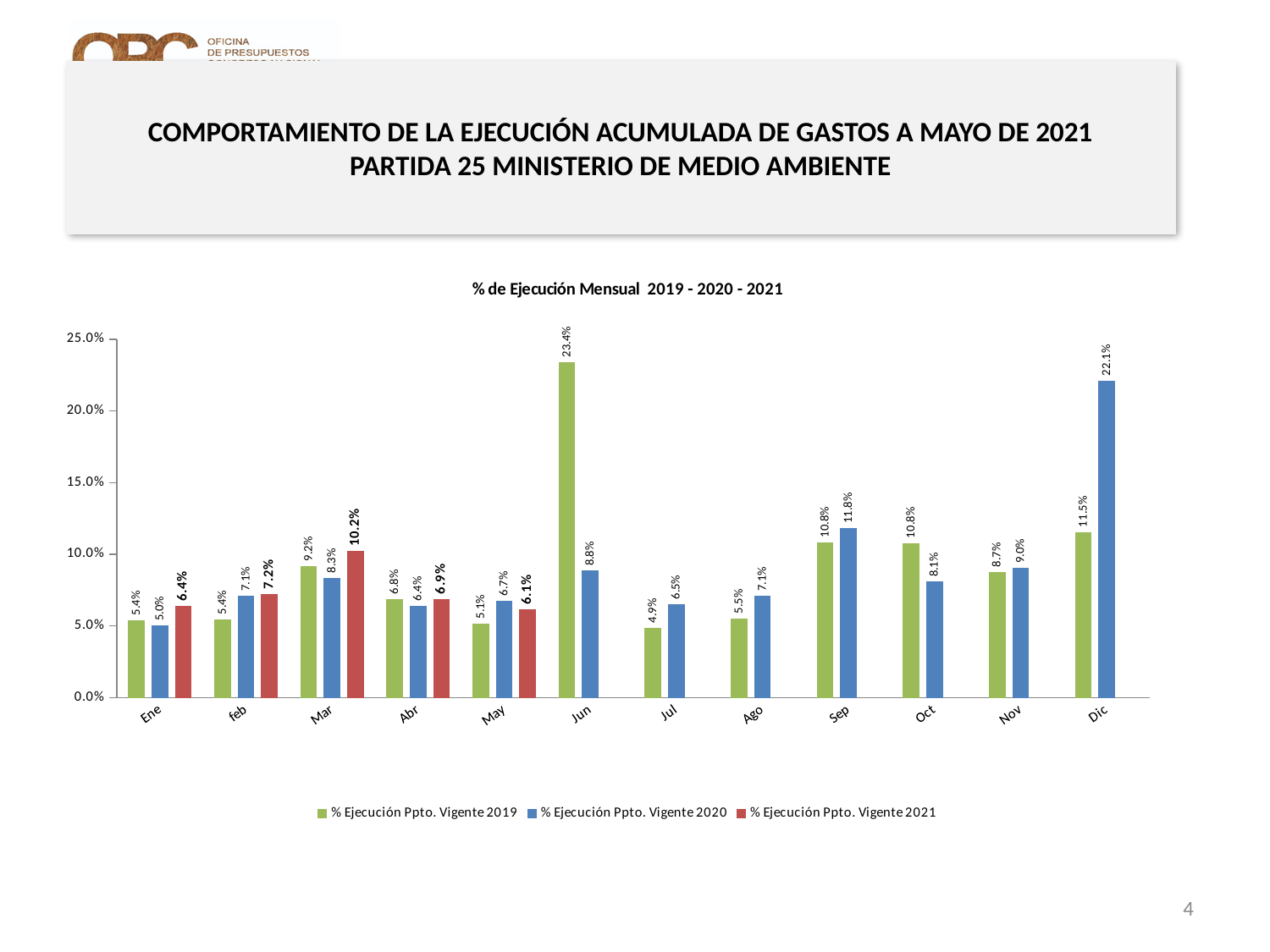
What is the value for % Ejecución Ppto. Vigente 2019 in Jun? 23.4% What is the value for % Ejecución Ppto. Vigente 2020 in Dic? 22.1% What is the difference between the 2020 and 2019 values in Dic? 10.6% How many months are shown on the x axis? 12 What is the title of the chart? % de Ejecución Mensual 2019 - 2020 - 2021 What kind of chart is shown? bar chart Which month has the lowest value for % Ejecución Ppto. Vigente 2020? Ene Which month has the highest value for % Ejecución Ppto. Vigente 2019? Jun What is the value for % Ejecución Ppto. Vigente 2021 in Mar? 10.2% How many series does the legend list? 3 Which is larger in Sep: the 2019 value or the 2020 value? 2020 Is the value for % Ejecución Ppto. Vigente 2019 in Jun greater or less than 20.0%? greater